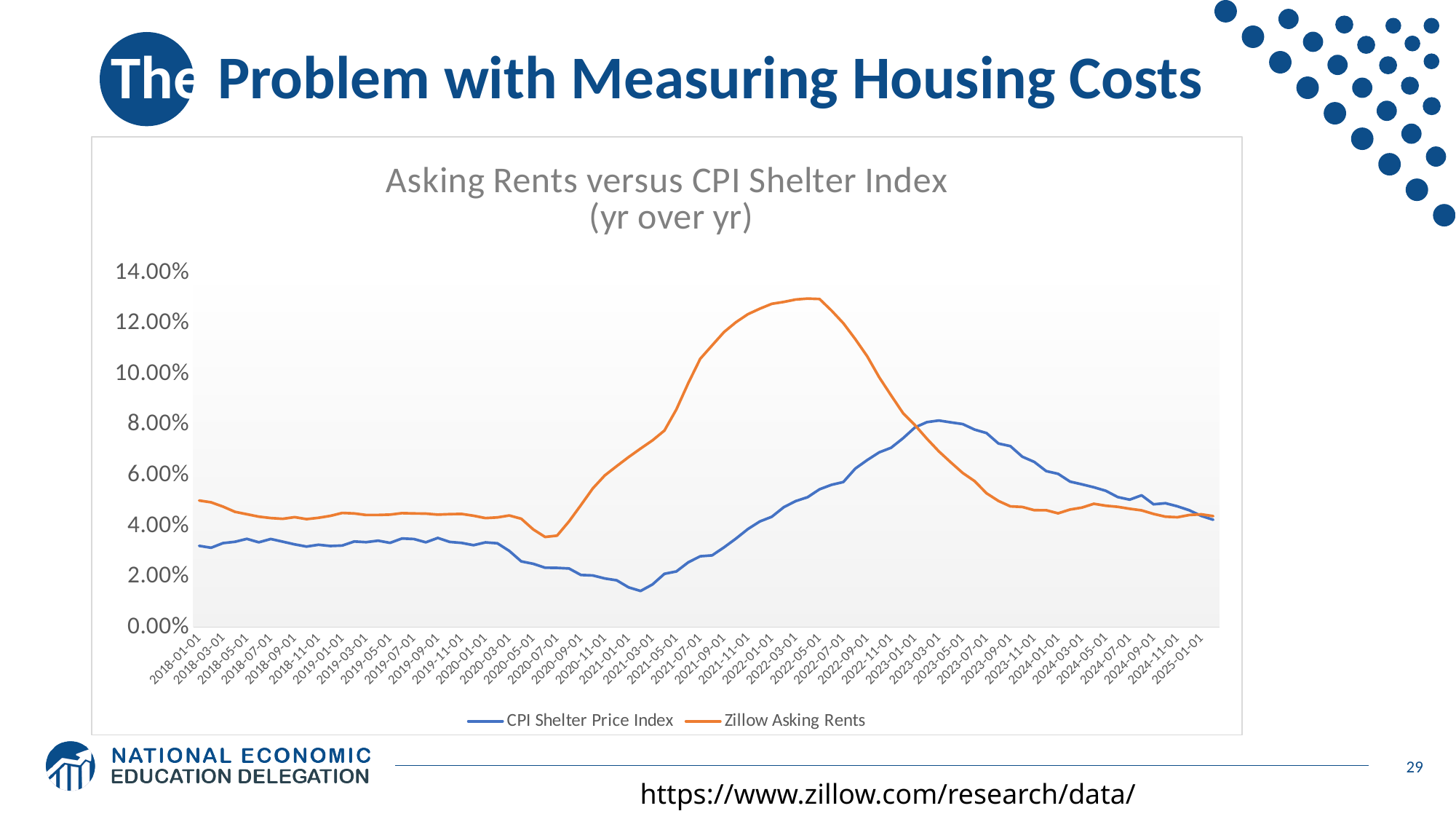
Which series reaches the highest value on the chart? Zillow Asking Rents At 2023-09-01, which series has the higher value, CPI Shelter Price Index or Zillow Asking Rents? CPI Shelter Price Index What is the title of the chart? Asking Rents versus CPI Shelter Index (yr over yr) What kind of chart is shown on the slide? Line chart Is the value of Zillow Asking Rents at 2020-07-01 greater or less than 4.00%? less Is the value of the CPI Shelter Price Index at 2021-01-01 greater or less than 2.00%? less At 2022-03-01, which series has the higher value, CPI Shelter Price Index or Zillow Asking Rents? Zillow Asking Rents Which series is drawn in orange? Zillow Asking Rents How many series does the legend list? 2 Is the peak value of Zillow Asking Rents greater or less than 12.00%? greater Does the Zillow Asking Rents series rise or fall between 2022-05-01 and 2023-09-01? fall Which series reaches the lowest value on the chart? CPI Shelter Price Index